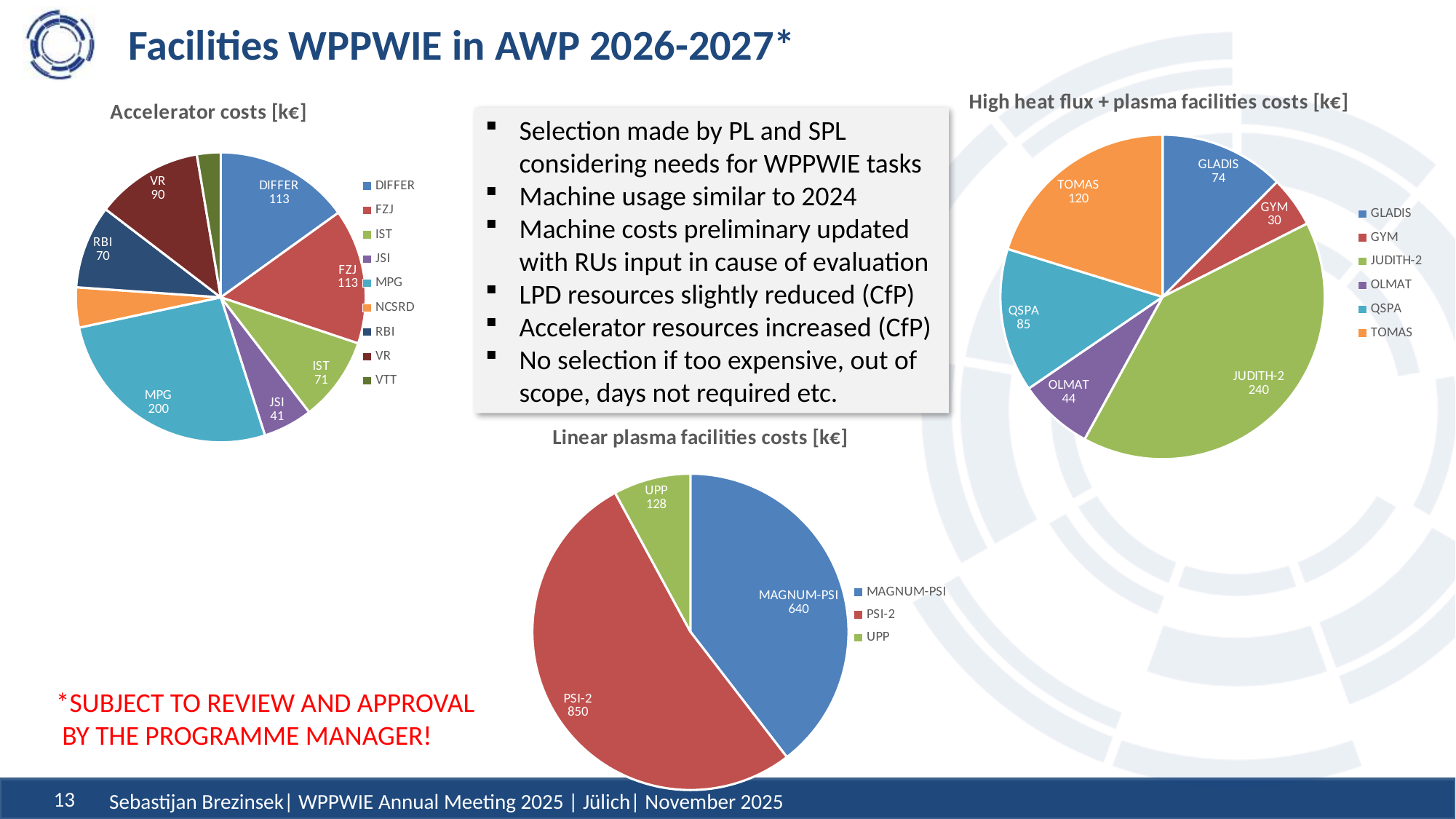
What kind of chart is the Linear plasma facilities costs [k€] chart? Pie chart In the High heat flux + plasma facilities costs [k€] chart, what is the value for QSPA? 85 In the Linear plasma facilities costs [k€] chart, what is the value for PSI-2? 850 In the Accelerator costs [k€] chart, what is the value for MPG? 200 In the High heat flux + plasma facilities costs [k€] chart, which facility has the smallest slice? GYM In the High heat flux + plasma facilities costs [k€] chart, which facility has the largest slice? JUDITH-2 In the Linear plasma facilities costs [k€] chart, which is larger, MAGNUM-PSI or UPP? MAGNUM-PSI In the Accelerator costs [k€] chart, which facility has the largest slice? MPG In the High heat flux + plasma facilities costs [k€] chart, what is the difference between TOMAS and GLADIS? 46 How many entries does the legend of the Accelerator costs [k€] chart list? 9 How many slices does the Linear plasma facilities costs [k€] chart have? 3 In the Accelerator costs [k€] chart, what is the difference between the values for VR and RBI? 20